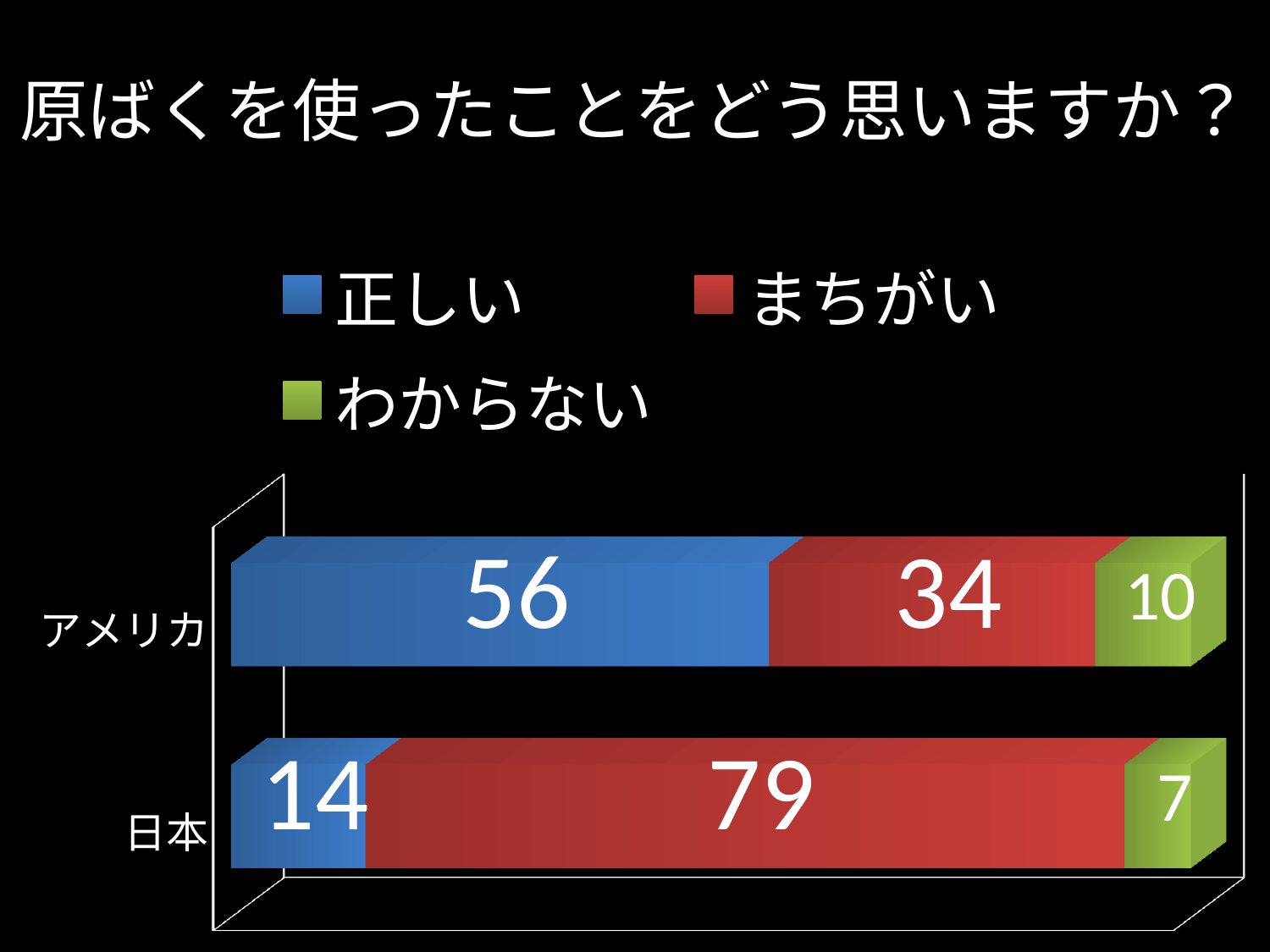
What is the total of the stacked bar for 日本? 100 Which category has the higher value for まちがい, アメリカ or 日本? 日本 What kind of chart is shown on the slide? Stacked bar chart Which category has the lower value for わからない? 日本 What is the difference between the 正しい values for アメリカ and 日本? 42 What is the value for まちがい for 日本? 79 What is the value for 正しい for アメリカ? 56 What is the value for 正しい for 日本? 14 What is the value for わからない for アメリカ? 10 How many categories are shown on the chart? 2 Which colour represents まちがい in the legend? Red How many series does the legend list? 3